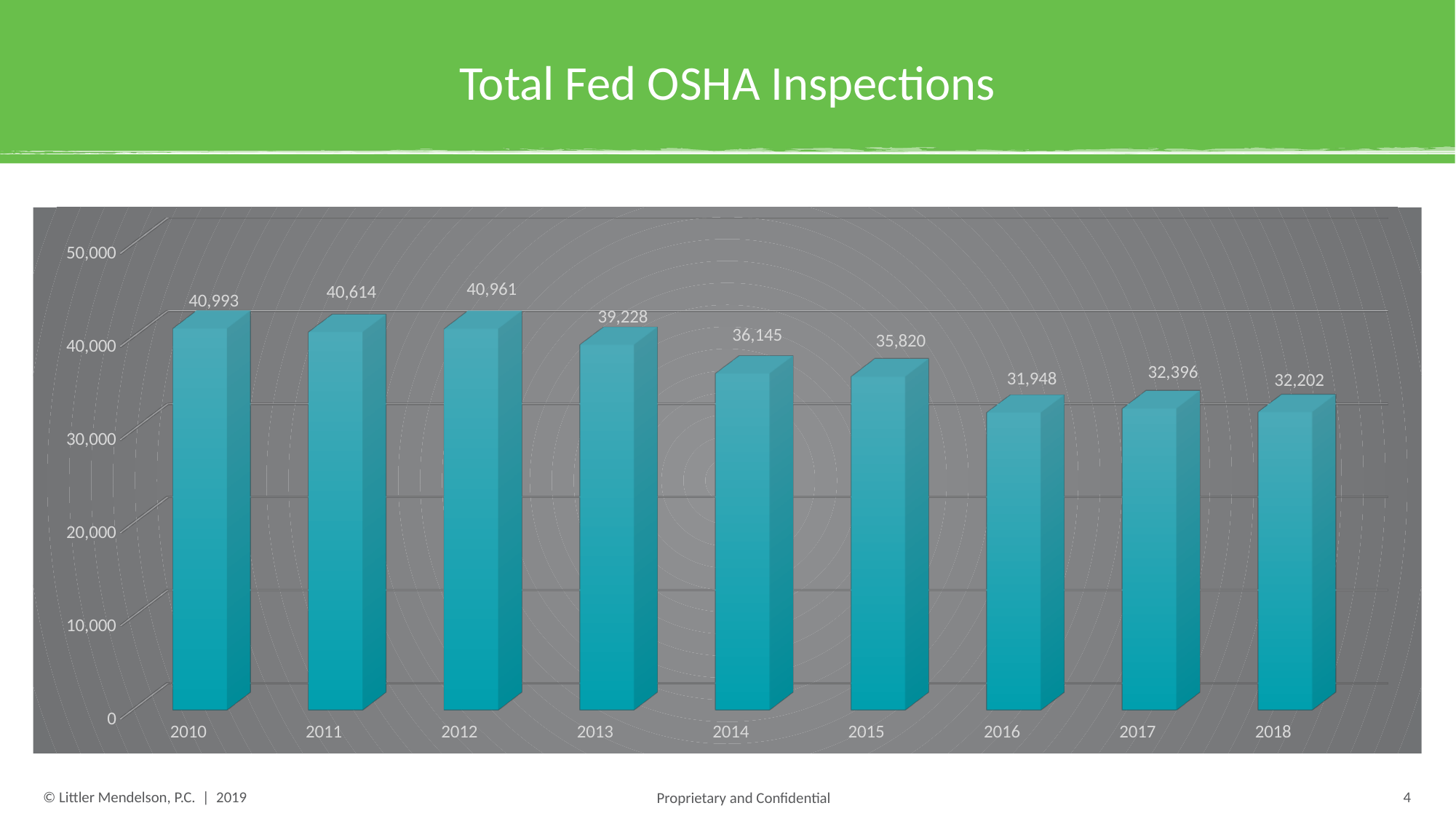
Do the values generally rise or fall from 2010 to 2018? fall Which is larger, the value for 2017 or the value for 2018? 2017 Which year has the highest value? 2010 What is the value for 2010? 40,993 What is the value for 2015? 35,820 What is the value for 2018? 32,202 Is the value for 2014 greater or less than 40,000? less What is the difference between the values for 2013 and 2014? 3,083 How many years are shown on the x axis? 9 What kind of chart is shown? bar chart Which year has the lowest value? 2016 What is the title of the slide? Total Fed OSHA Inspections